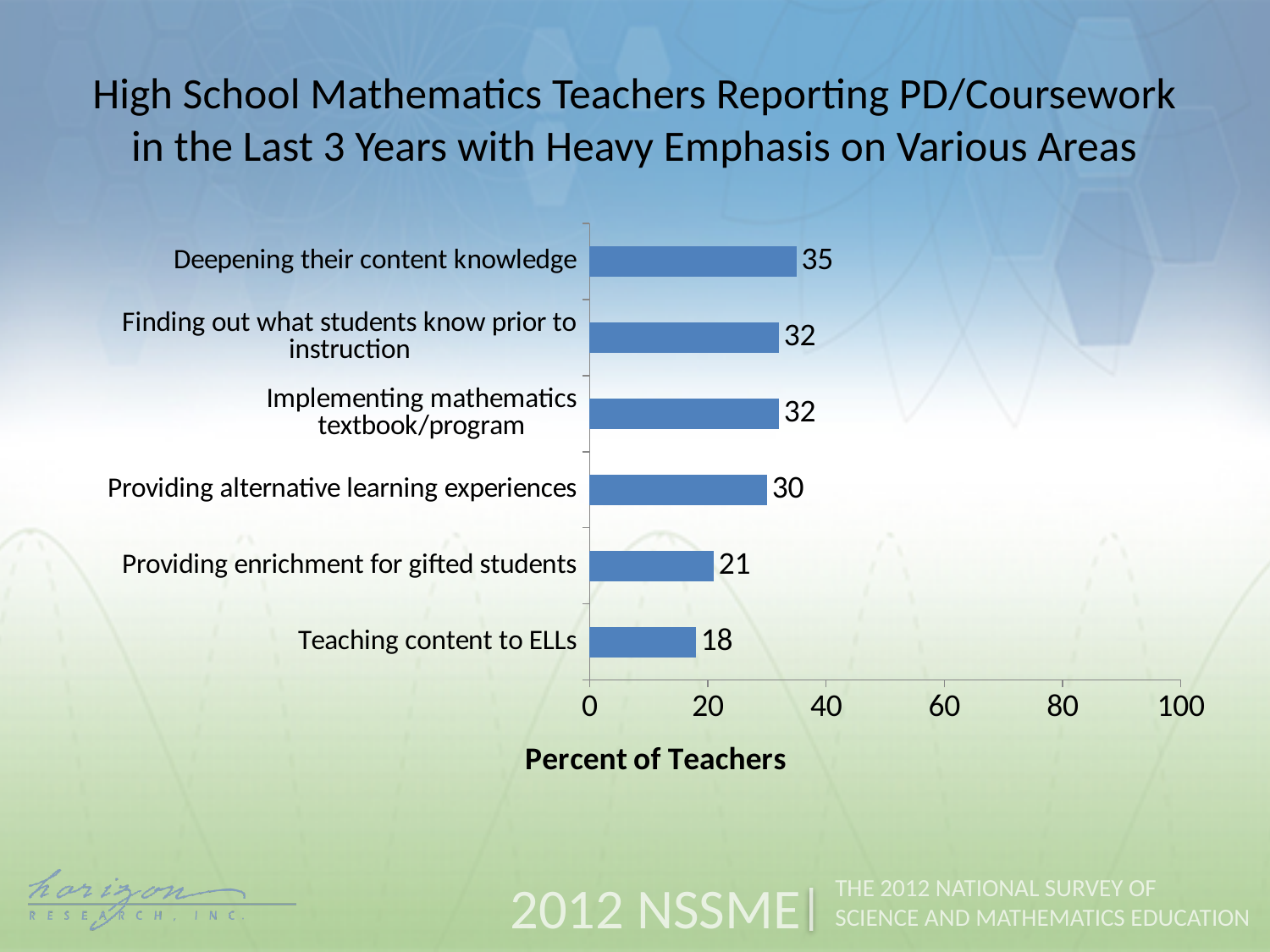
Which is larger: the value for Providing alternative learning experiences or the value for Providing enrichment for gifted students? Providing alternative learning experiences How many areas are shown in the chart? 6 What is the label of the horizontal axis? Percent of Teachers What is the difference between the values for Deepening their content knowledge and Teaching content to ELLs? 17 Which area has the highest percent of teachers? Deepening their content knowledge What is the value for Providing enrichment for gifted students? 21 Is the value for Finding out what students know prior to instruction greater or less than 40? less What is the value for Providing alternative learning experiences? 30 What is the value for Teaching content to ELLs? 18 What kind of chart is shown on the slide? Bar chart Which area has the lowest percent of teachers? Teaching content to ELLs What percent of teachers reported PD/coursework with heavy emphasis on deepening their content knowledge? 35